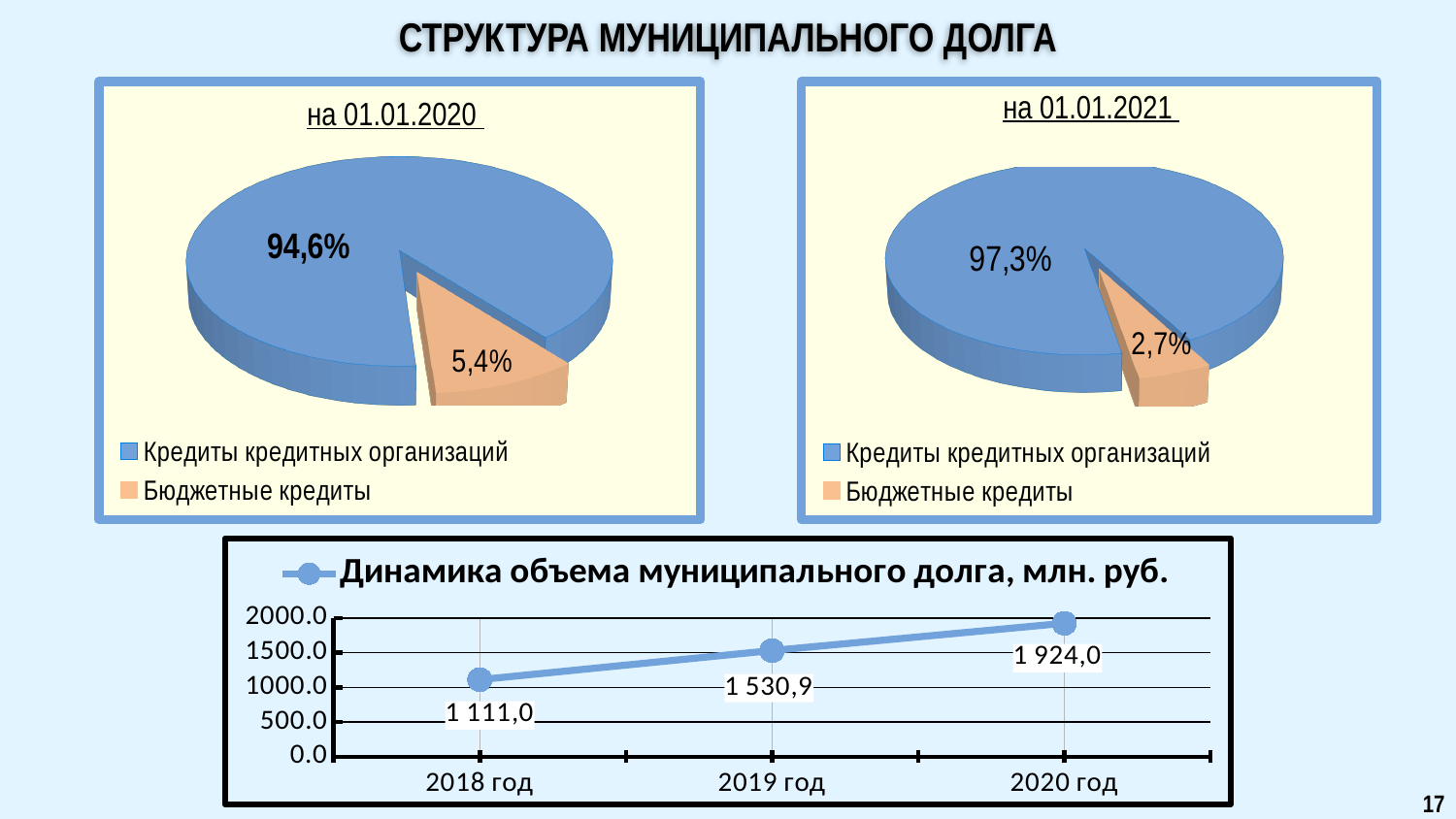
In the chart 'Динамика объема муниципального долга, млн. руб.', what is the value for 2020 год? 1 924,0 What kind of chart is 'Динамика объема муниципального долга, млн. руб.'? line chart In the chart 'Динамика объема муниципального долга, млн. руб.', which year has the lowest value? 2018 год In the pie chart 'на 01.01.2021', which category has the largest slice? Кредиты кредитных организаций In the chart 'Динамика объема муниципального долга, млн. руб.', do the values rise or fall from 2018 год to 2020 год? rise In the chart 'Динамика объема муниципального долга, млн. руб.', what is the difference between the values for 2020 год and 2018 год? 813,0 In the pie chart 'на 01.01.2021', what share is 'Бюджетные кредиты'? 2,7% In the chart 'Динамика объема муниципального долга, млн. руб.', what is the value for 2019 год? 1 530,9 In the pie chart 'на 01.01.2021', what share is 'Кредиты кредитных организаций'? 97,3% In the pie chart 'на 01.01.2020', what share is 'Бюджетные кредиты'? 5,4% In the pie chart 'на 01.01.2020', how many slices does the pie have? 2